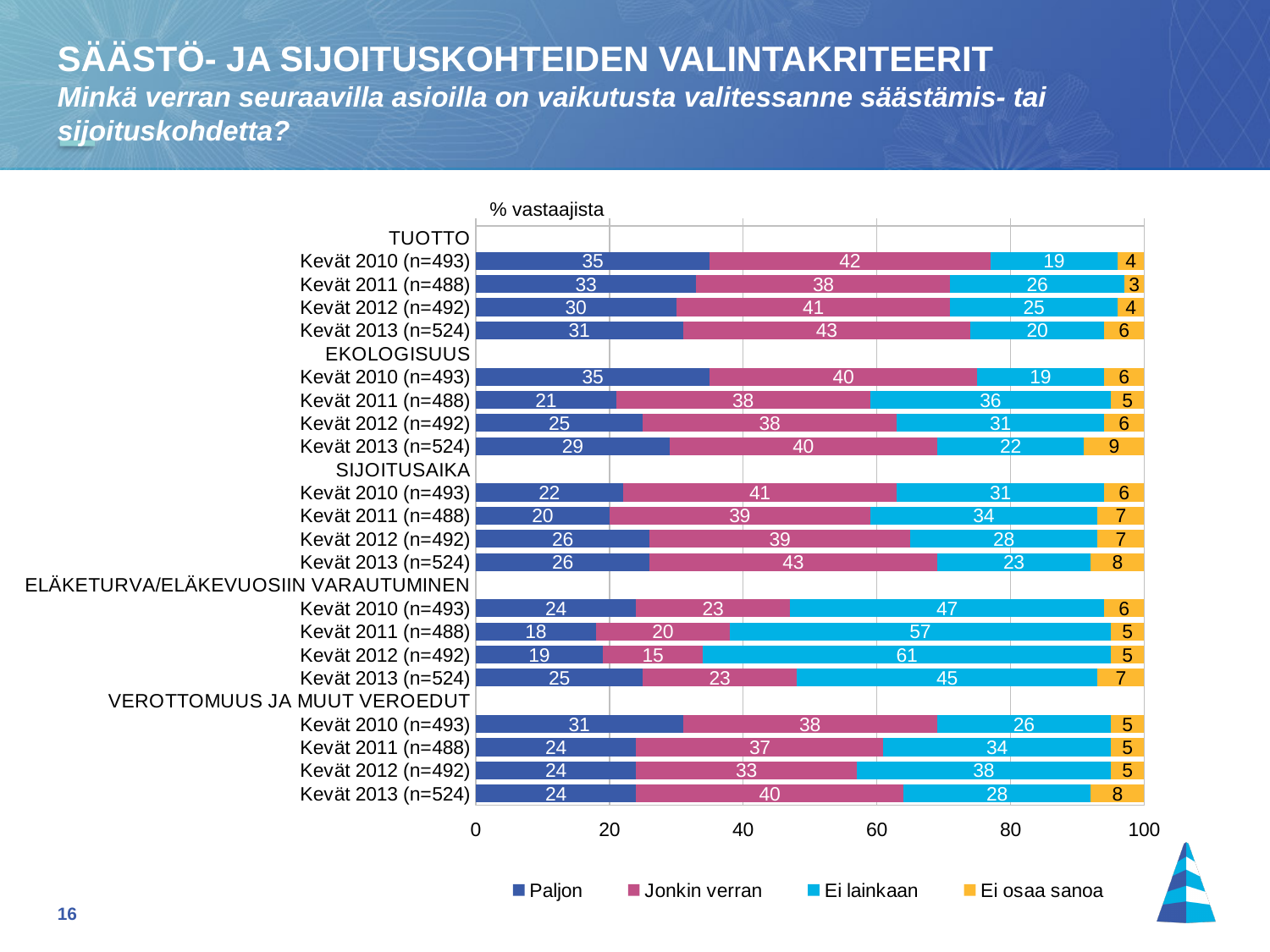
Which is larger: the 'Ei lainkaan' value for SIJOITUSAIKA Kevät 2011 (n=488) or for SIJOITUSAIKA Kevät 2013 (n=524)? Kevät 2011 (n=488) What is the 'Ei lainkaan' value for ELÄKETURVA/ELÄKEVUOSIIN VARAUTUMINEN, Kevät 2012 (n=492)? 61 Which row has the lowest 'Jonkin verran' value in the chart? ELÄKETURVA/ELÄKEVUOSIIN VARAUTUMINEN, Kevät 2012 (n=492) What is the difference between the 'Paljon' values for EKOLOGISUUS in Kevät 2010 (n=493) and Kevät 2011 (n=488)? 14 What is the 'Jonkin verran' value for VEROTTOMUUS JA MUUT VEROEDUT, Kevät 2013 (n=524)? 40 How many series does the legend list? 4 How many category groups (criteria) are shown in the chart? 5 What type of chart is shown on the slide? Stacked horizontal bar chart What is the 'Paljon' value for TUOTTO, Kevät 2010 (n=493)? 35 What is the total of the stacked bar for TUOTTO, Kevät 2013 (n=524)? 100 Which row has the highest 'Ei lainkaan' value in the chart? ELÄKETURVA/ELÄKEVUOSIIN VARAUTUMINEN, Kevät 2012 (n=492) What label is shown above the chart's plot area indicating the unit of the values? % vastaajista